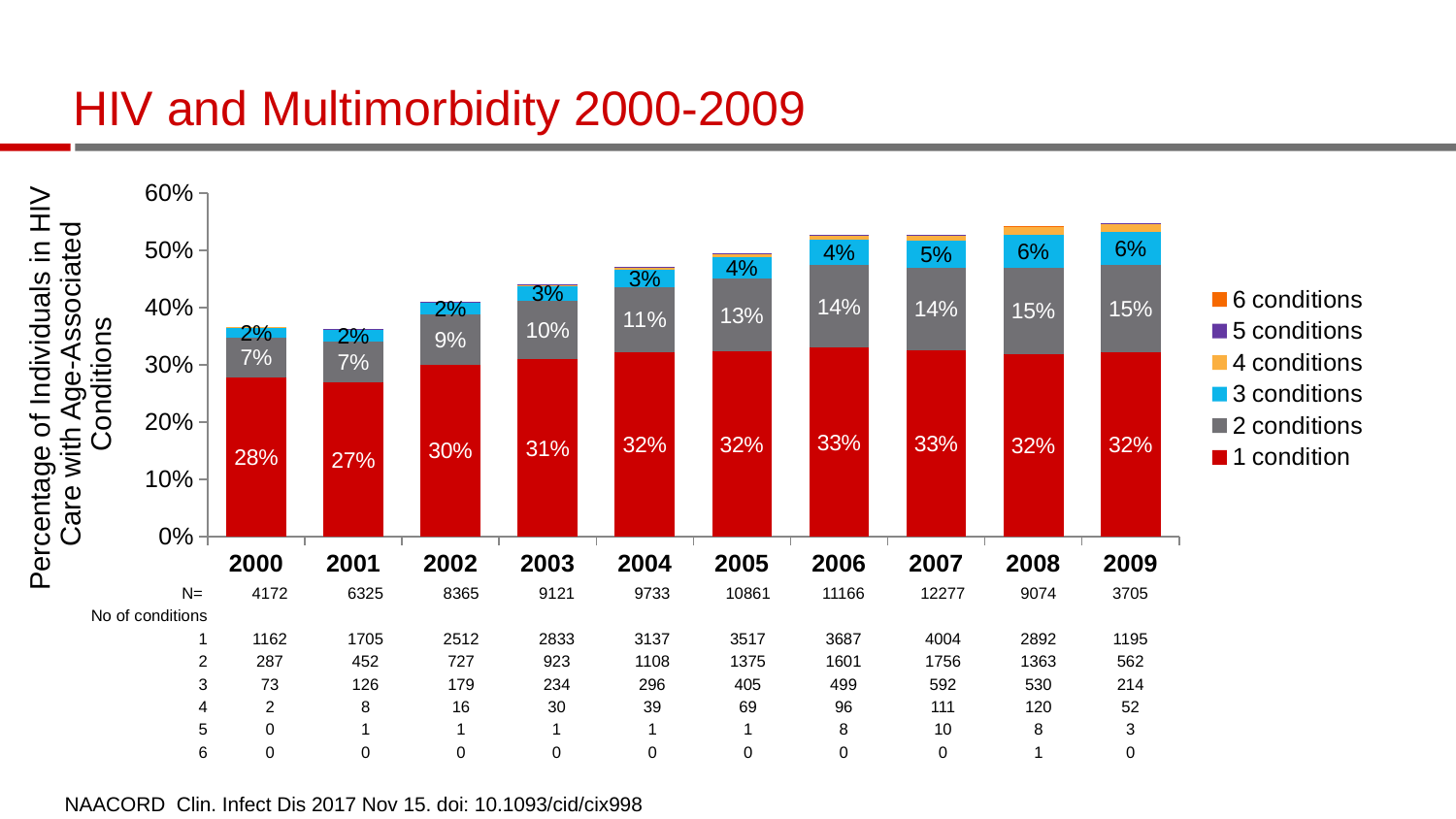
What type of chart is shown on the slide? stacked bar chart How many years are shown on the x axis of the chart? 10 Which is larger, the 2 conditions value in 2004 or in 2002? 2004 How many series does the legend list? 6 What is the title of the chart on the slide? HIV and Multimorbidity 2000-2009 Which year has the lowest value for 1 condition? 2001 What is the value for 2 conditions in 2005? 13% Is the total height of the 2009 stacked bar greater or less than 50%? greater Does the value for 2 conditions generally rise or fall from 2000 to 2009? rise What is the difference between the 2 conditions value in 2009 and in 2000? 8% What is the value for 1 condition in 2000? 28% What is the value for 3 conditions in 2009? 6%